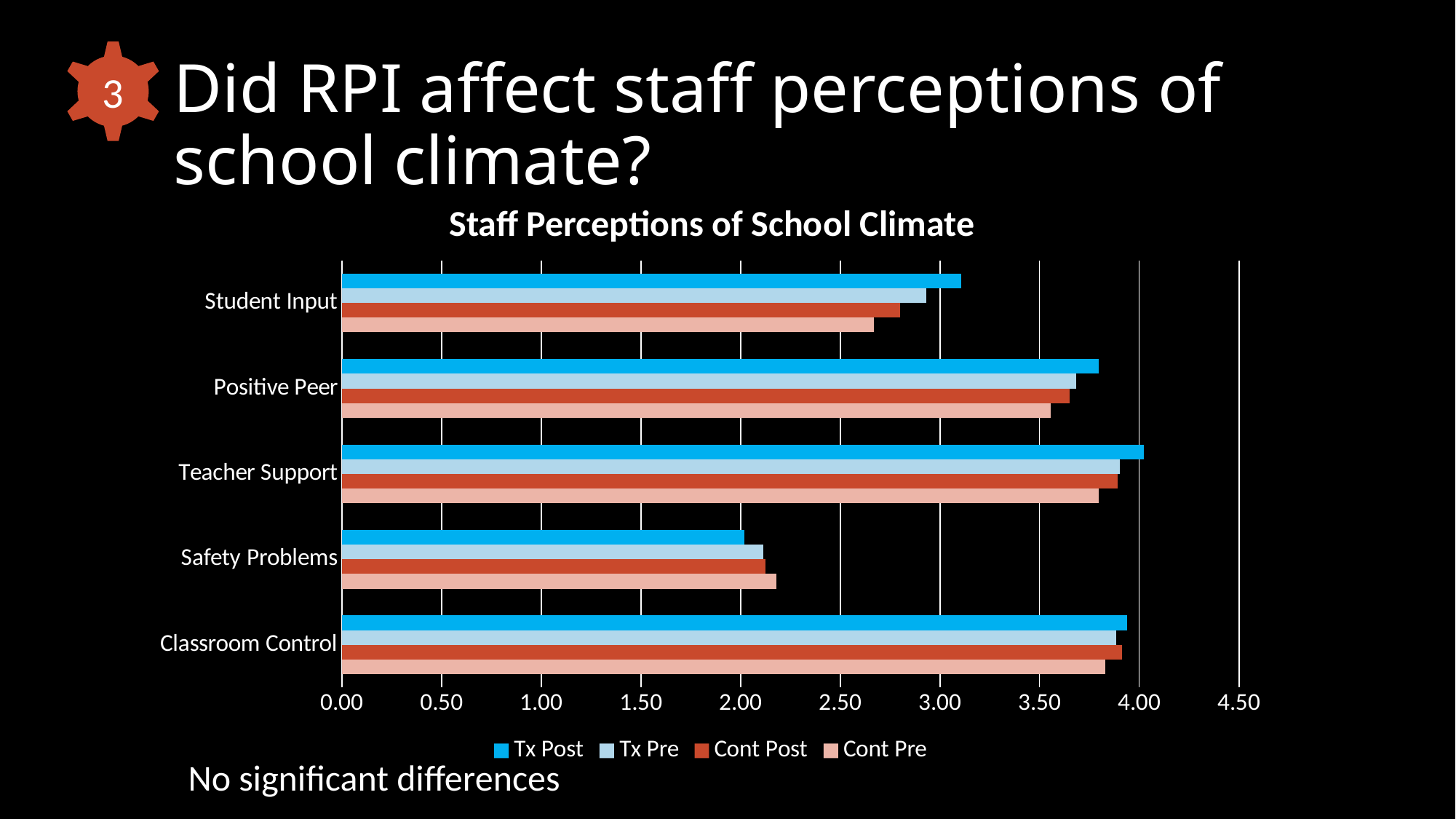
Is the Cont Pre value for Student Input greater or less than 3.00? less Is the Tx Pre value for Safety Problems greater or less than 2.50? less What is the title of the chart? Staff Perceptions of School Climate Which category has the lowest values across all series? Safety Problems Which is larger: the Tx Post value for Teacher Support or the Tx Post value for Student Input? Teacher Support For Student Input, which is larger: the Tx Post value or the Cont Pre value? Tx Post Which legend entry is shown in the darkest blue colour? Tx Post Is the Tx Post value for Positive Peer greater or less than 3.50? greater What kind of chart is shown on the slide? Bar chart How many categories are shown on the vertical axis of the chart? 5 How many series does the legend list? 4